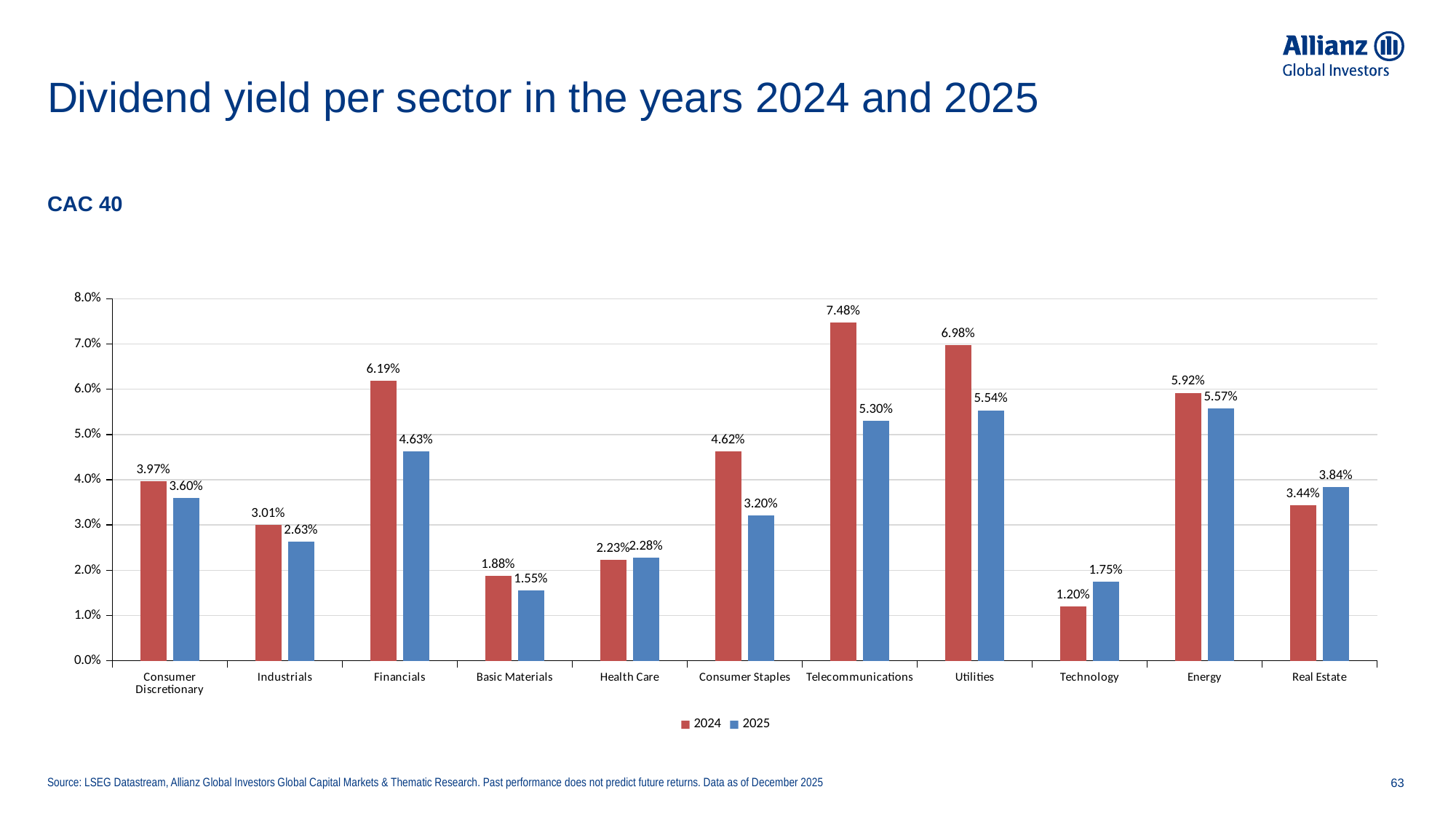
How many series does the legend list? 2 How many sectors are shown on the x axis? 11 What is the 2025 dividend yield for Real Estate? 3.84% Which is larger for Energy: the 2024 or the 2025 dividend yield? 2024 Which index does the chart cover, according to the label above it? CAC 40 What is the 2025 dividend yield for Financials? 4.63% What kind of chart is shown on the slide? Bar chart What is the difference between the 2024 and 2025 dividend yields for Utilities? 1.44% Which sector has the lowest 2025 dividend yield? Basic Materials Which sector has the highest 2024 dividend yield? Telecommunications Is the 2024 dividend yield for Consumer Staples greater or less than 4.0%? greater What is the 2024 dividend yield for Telecommunications? 7.48%